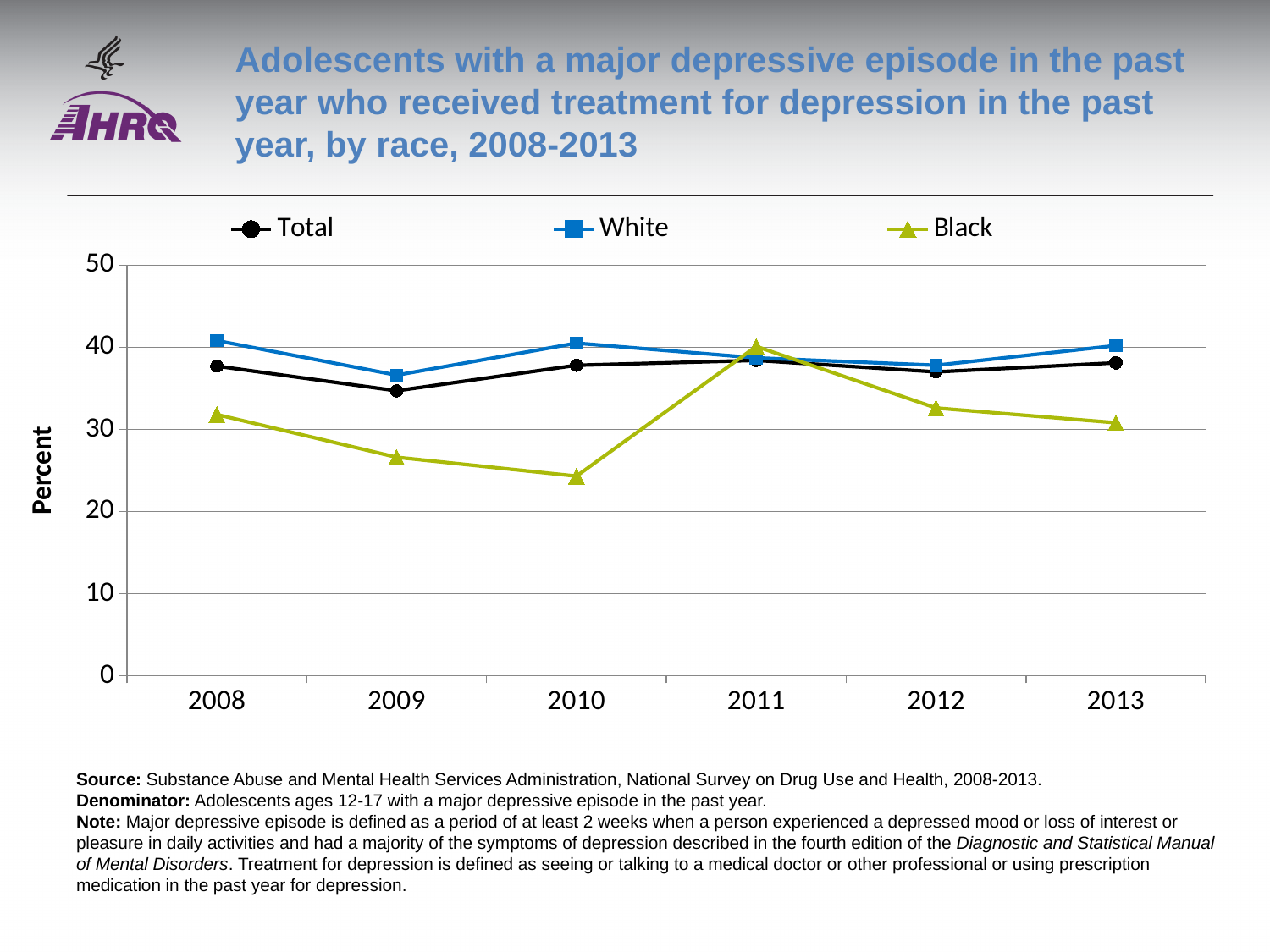
In which year is the value for Black lowest? 2010 In 2010, which is larger, the value for White or the value for Black? White Does the value for Black rise or fall from 2008 to 2010? fall Is the value for Total in 2009 greater or less than 30? greater How many series does the legend list? 3 In which year is the value for Black highest? 2011 Is the value for White in 2009 greater or less than 40? less What kind of chart is shown on the slide? line chart In which year is the value for Total lowest? 2009 How many years are plotted along the x axis? 6 What is the label on the y axis? Percent Is the value for Black in 2010 greater or less than 30? less